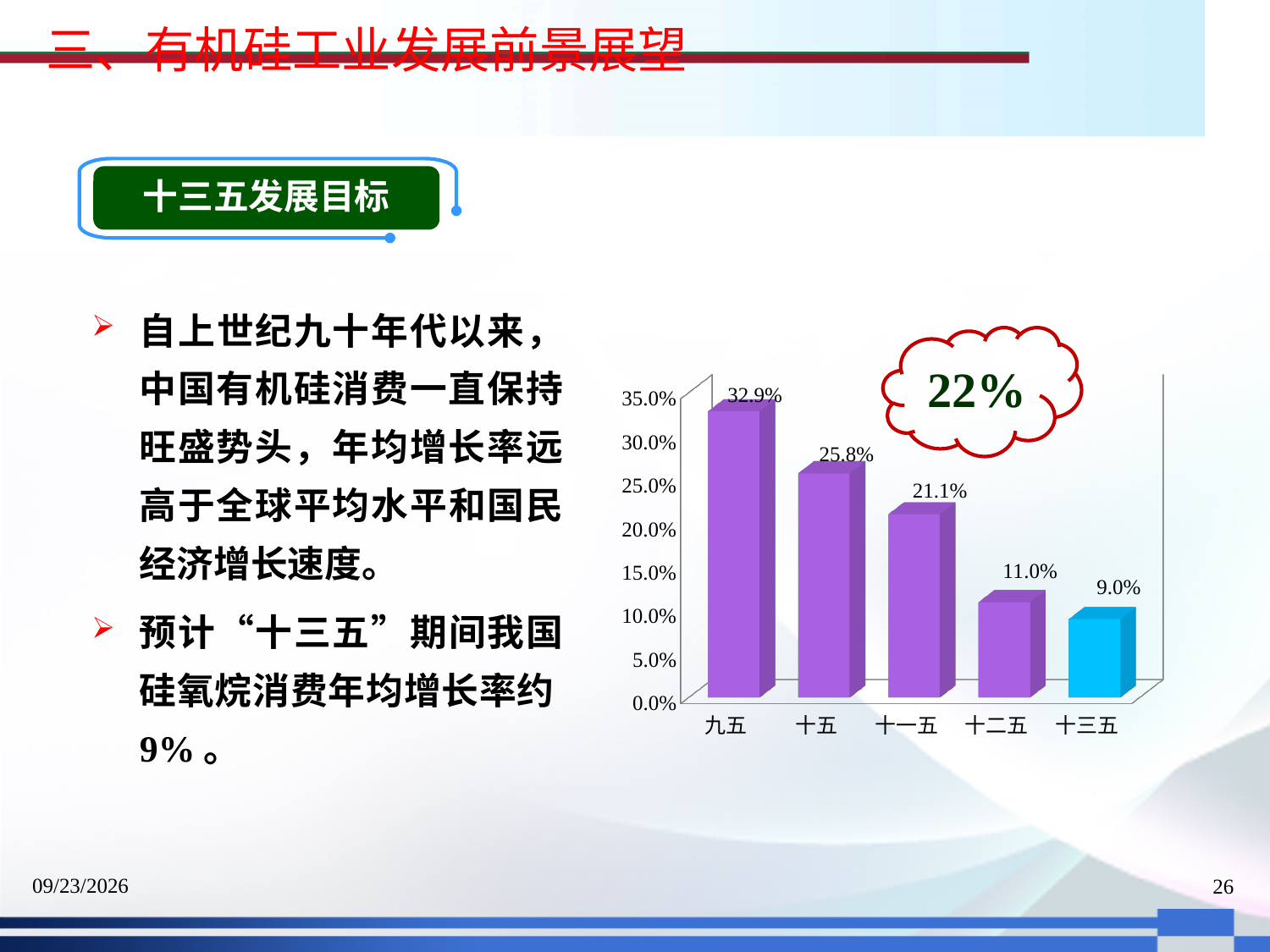
What is the value for 九五? 32.9% Is the value for 十五 greater or less than 20.0%? greater Which category has the lowest value? 十三五 What is the value for 十三五? 9.0% Which category has the highest value? 九五 What is the difference between the values for 十五 and 十二五? 14.8% Which is larger, the value for 十一五 or the value for 十二五? 十一五 What kind of chart is shown on the slide? bar chart How many categories are shown on the x axis? 5 What is the value for 十一五? 21.1% Do the values rise or fall from 九五 to 十三五? fall What percentage is written in the cloud shape above the chart? 22%